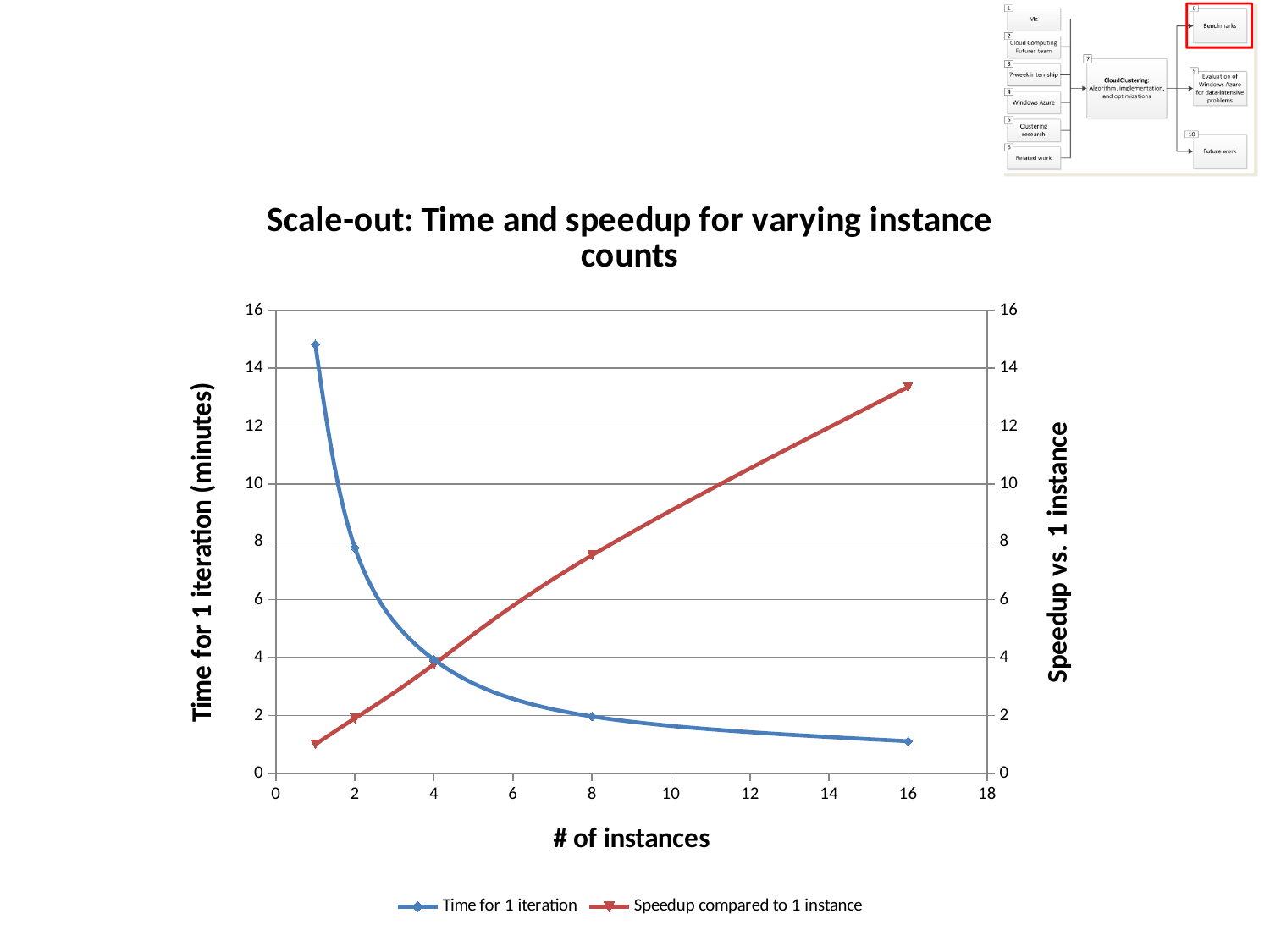
Is the value for 'Time for 1 iteration' at 1 instance greater or less than 14? greater Does the 'Time for 1 iteration' series rise or fall as the number of instances increases? Fall Does the 'Speedup compared to 1 instance' series rise or fall as the number of instances increases? Rise Is the value for 'Speedup compared to 1 instance' at 2 instances greater or less than 4? less Is the value for 'Time for 1 iteration' at 16 instances greater or less than 2? less How many series does the legend list? 2 What is the title of the chart? Scale-out: Time and speedup for varying instance counts What kind of chart is shown on the slide? Line chart What is the label of the x axis? # of instances How many data points are plotted for the 'Time for 1 iteration' series? 5